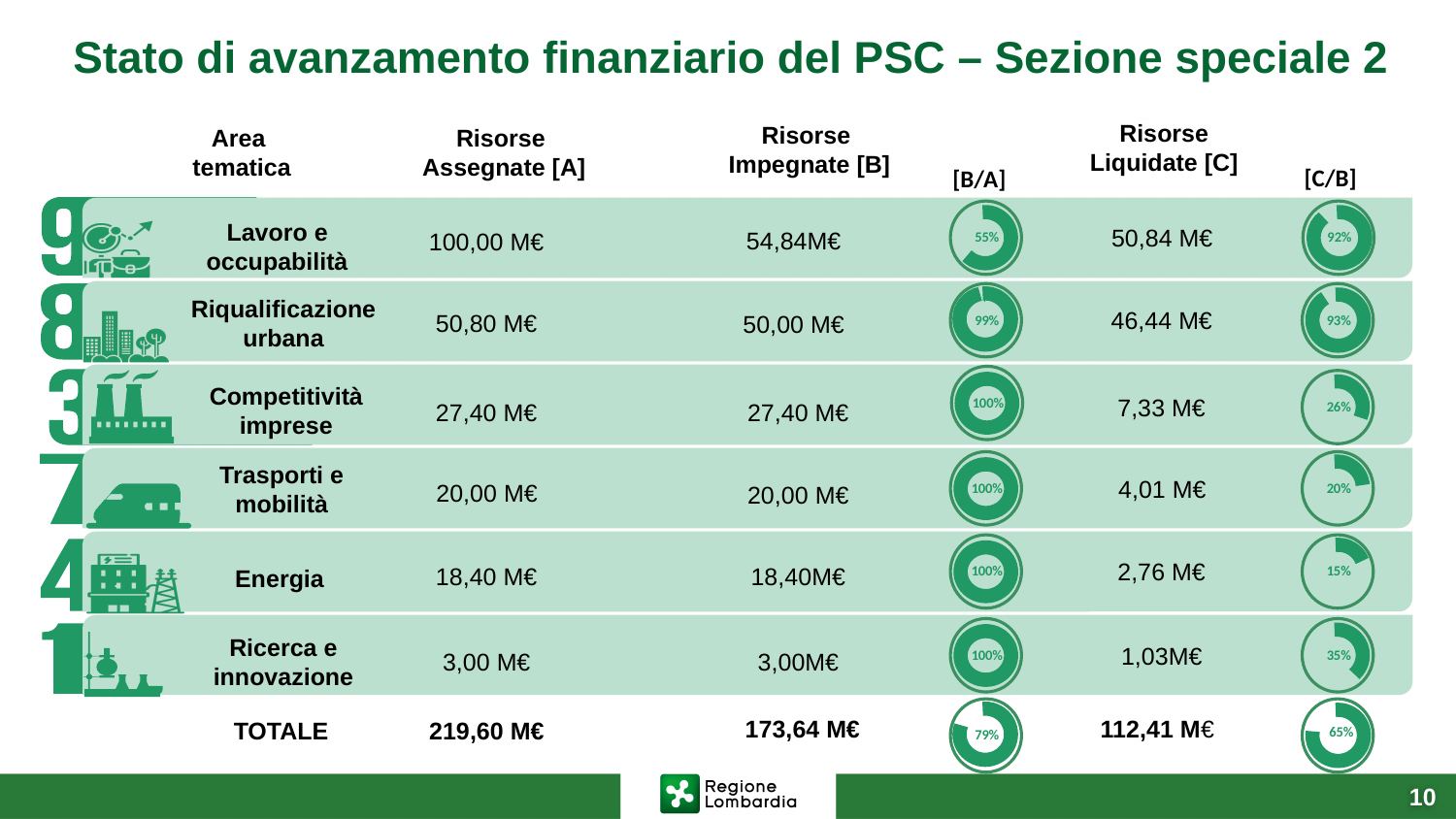
Among the six thematic areas, which one has the lowest percentage in the [C/B] donut charts? Energia In the [C/B] column, what percentage does the donut chart for the TOTALE row show? 65% In the [B/A] column, what percentage does the donut chart for Lavoro e occupabilità show? 55% What kind of chart is used to display the [B/A] and [C/B] percentages? Donut chart Among the six thematic areas, which one has the lowest percentage in the [B/A] donut charts? Lavoro e occupabilità How many thematic areas show 100% in the [B/A] donut charts? 4 In the [B/A] column, what percentage does the donut chart for the TOTALE row show? 79% What is the difference between the [B/A] and [C/B] percentages for Lavoro e occupabilità? 37% What is the difference between the [C/B] percentages for Riqualificazione urbana and Trasporti e mobilità? 73% In the [C/B] column, what percentage does the donut chart for Riqualificazione urbana show? 93% In the [C/B] column, what percentage does the donut chart for Energia show? 15% In the [C/B] column, which has the higher percentage: Competitività imprese or Ricerca e innovazione? Ricerca e innovazione